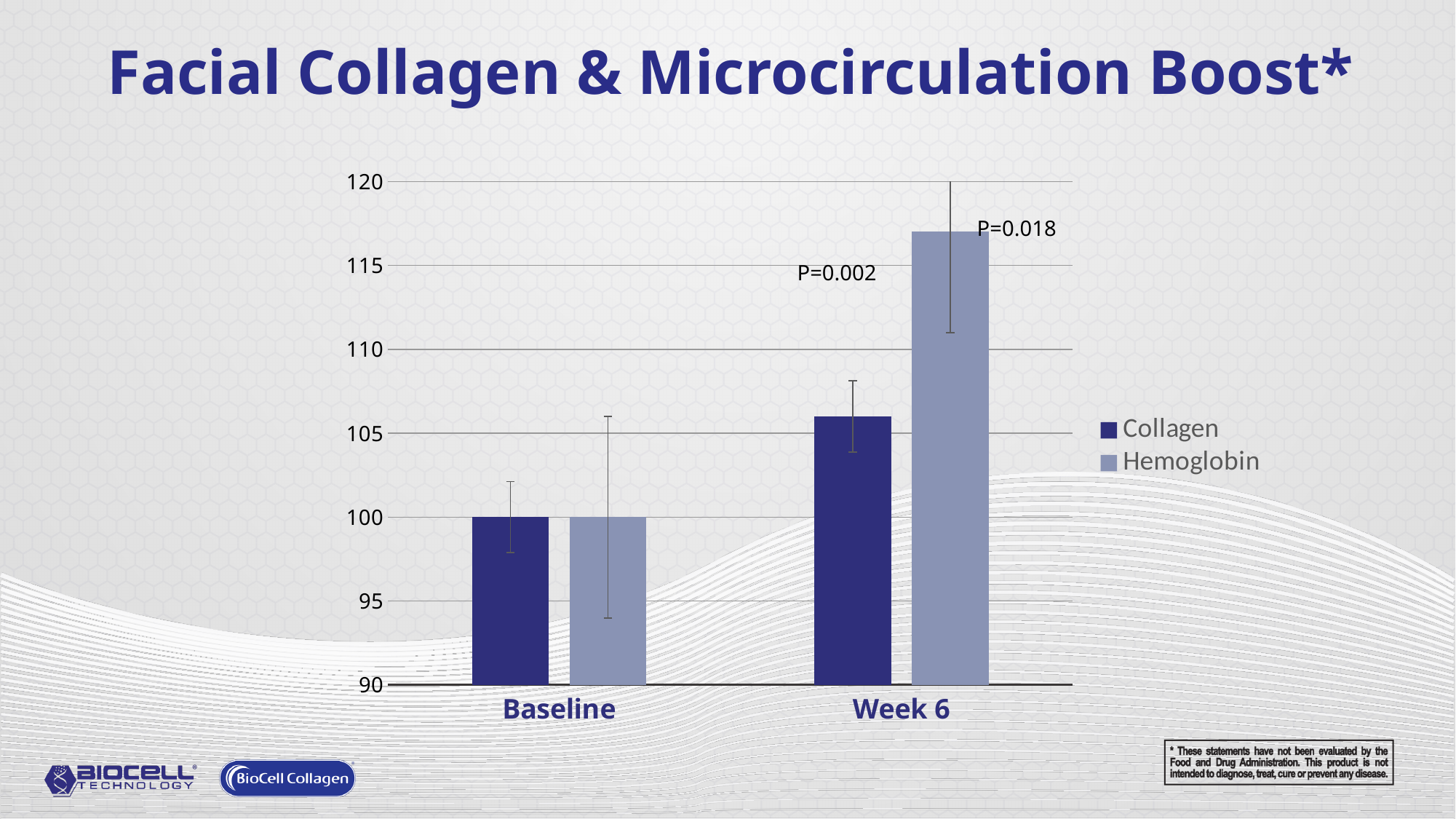
What is the value for Hemoglobin at Baseline? 100 What kind of chart is shown on the slide? bar chart Which bar is the highest in the chart? Hemoglobin at Week 6 What P-value is printed next to the Hemoglobin bar at Week 6? P=0.018 At Week 6, which is larger, Collagen or Hemoglobin? Hemoglobin How many series does the legend list? 2 Do the Hemoglobin values rise or fall from Baseline to Week 6? rise How many categories are shown on the x axis? 2 What P-value is printed above the Collagen bar at Week 6? P=0.002 What is the value for Collagen at Baseline? 100 Is the value for Hemoglobin at Week 6 greater or less than 115? greater Is the value for Collagen at Week 6 greater or less than 105? greater